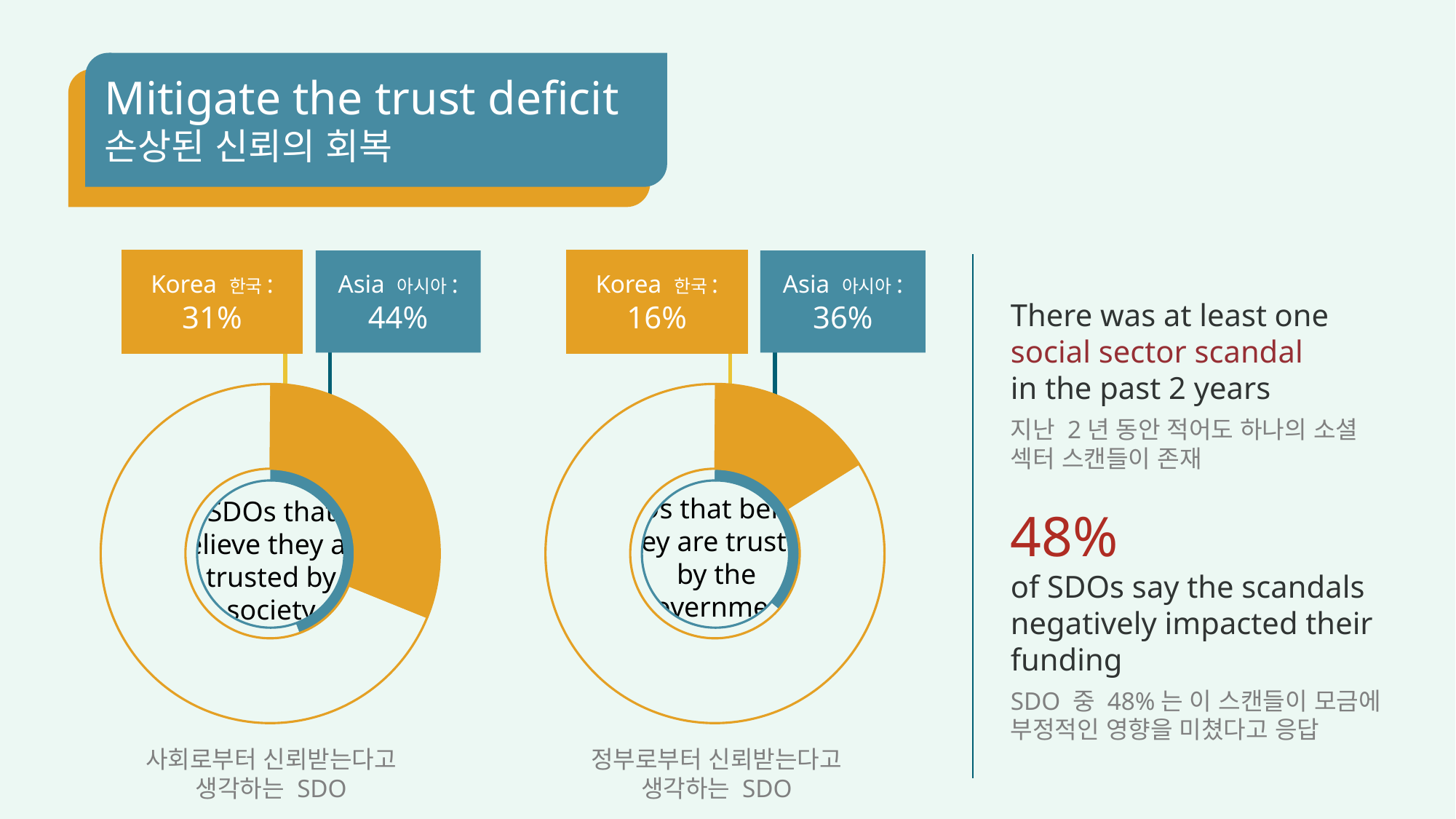
On the right chart, which is larger, the value for Korea or the value for Asia? Asia On the left chart (SDOs that believe they are trusted by society), what is the value for Asia? 44% What kind of chart is the left chart? Doughnut chart On the left chart, which is larger, the value for Korea or the value for Asia? Asia On the left chart, what is the difference between the Asia value and the Korea value? 13% On the right chart, what is the difference between the Asia value and the Korea value? 20% What is the difference between the Korea value on the left chart and the Korea value on the right chart? 15% How many regions are labelled above each chart? 2 On the left chart (SDOs that believe they are trusted by society), what is the value for Korea? 31% On the right chart (SDOs that believe they are trusted by the government), what is the value for Korea? 16% On the left chart, which colour is used for the Korea label box? Orange On the right chart (SDOs that believe they are trusted by the government), what is the value for Asia? 36%